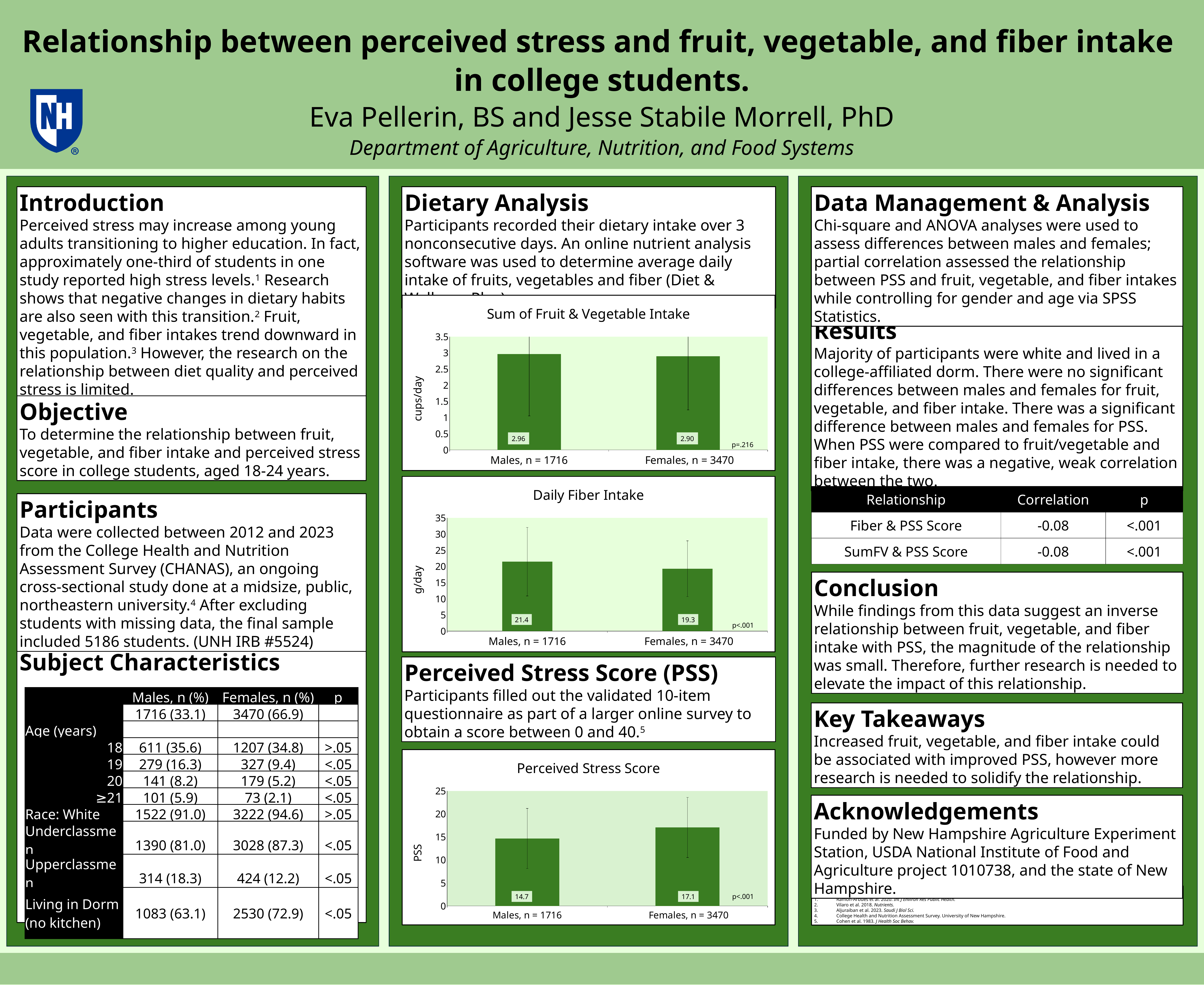
In the 'Daily Fiber Intake' chart, what is the value for Females, n = 3470? 19.3 What kind of chart is the 'Daily Fiber Intake' chart? bar chart In the 'Sum of Fruit & Vegetable Intake' chart, what is the value for Males, n = 1716? 2.96 In the 'Daily Fiber Intake' chart, which group has the lower value? Females, n = 3470 In the 'Perceived Stress Score' chart, what is the value for Females, n = 3470? 17.1 In the 'Perceived Stress Score' chart, which group has the higher value? Females, n = 3470 In the 'Sum of Fruit & Vegetable Intake' chart, what is the value for Females, n = 3470? 2.90 In the 'Perceived Stress Score' chart, what is the difference between the Females and Males values? 2.4 In the 'Daily Fiber Intake' chart, what is the value for Males, n = 1716? 21.4 In the 'Perceived Stress Score' chart, is the value for Males, n = 1716 greater or less than 15? less What is the y-axis label of the 'Sum of Fruit & Vegetable Intake' chart? cups/day In the 'Daily Fiber Intake' chart, what is the difference between the Males and Females values? 2.1